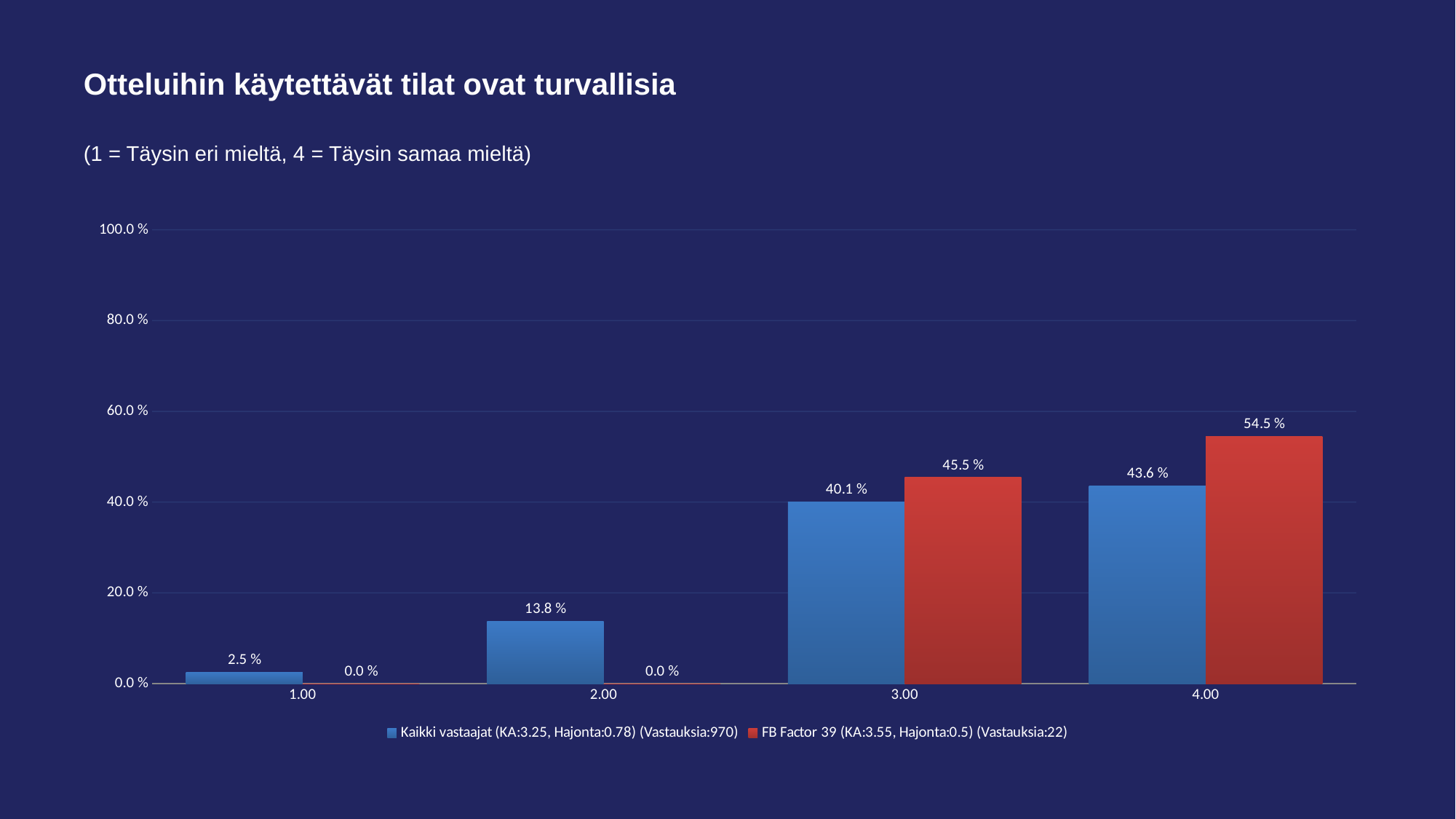
What is the value for Kaikki vastaajat at category 3.00? 40.1 % Which category has the lowest value for Kaikki vastaajat? 1.00 What is the value for FB Factor 39 at category 1.00? 0.0 % What is the difference between the FB Factor 39 and Kaikki vastaajat values at category 4.00? 10.9 % How many categories are shown on the x axis? 4 What is the value for Kaikki vastaajat at category 2.00? 13.8 % At category 3.00, which series has the larger value, Kaikki vastaajat or FB Factor 39? FB Factor 39 Which category has the highest value for FB Factor 39? 4.00 How many series does the legend list? 2 What is the title of the chart? Otteluihin käytettävät tilat ovat turvallisia What kind of chart is shown on the slide? Bar chart What is the value for FB Factor 39 at category 4.00? 54.5 %